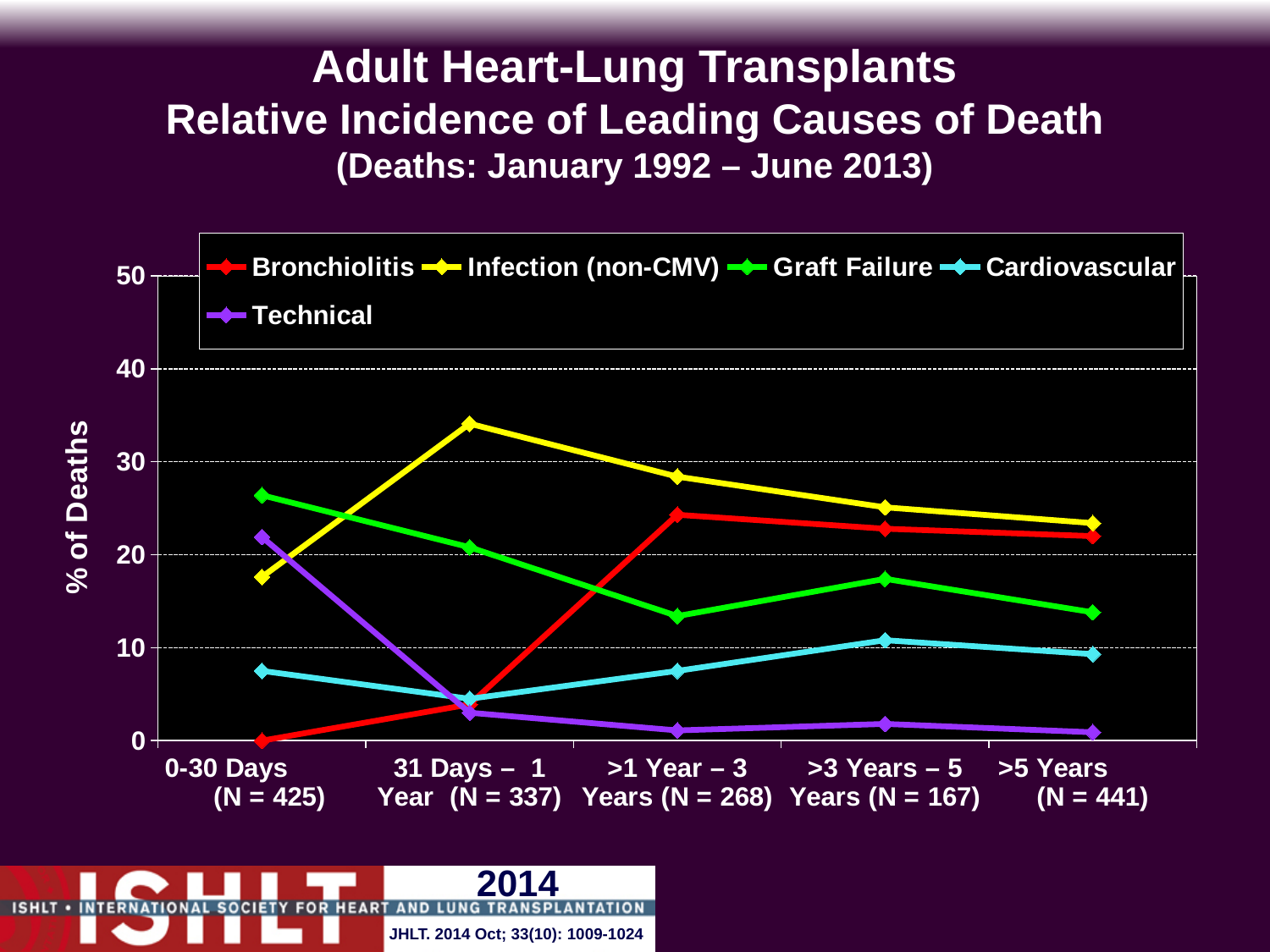
Is the value for Graft Failure at 0-30 Days greater or less than 20? greater What kind of chart is shown on the slide? line chart Does the Technical line rise or fall from 0-30 Days to 31 Days – 1 Year? fall At >5 Years, which is larger: Infection (non-CMV) or Graft Failure? Infection (non-CMV) Which cause of death has the lowest % of deaths in the >1 Year – 3 Years period? Technical Does the Infection (non-CMV) line rise or fall from 31 Days – 1 Year to >5 Years? fall Which cause of death has the highest % of deaths in the 31 Days – 1 Year period? Infection (non-CMV) Which cause of death has the highest % of deaths in the 0-30 Days period? Graft Failure How many time-period categories are shown on the x axis? 5 Is the value for Infection (non-CMV) at 31 Days – 1 Year greater or less than 30? greater How many series does the legend list? 5 What is the label on the y axis? % of Deaths